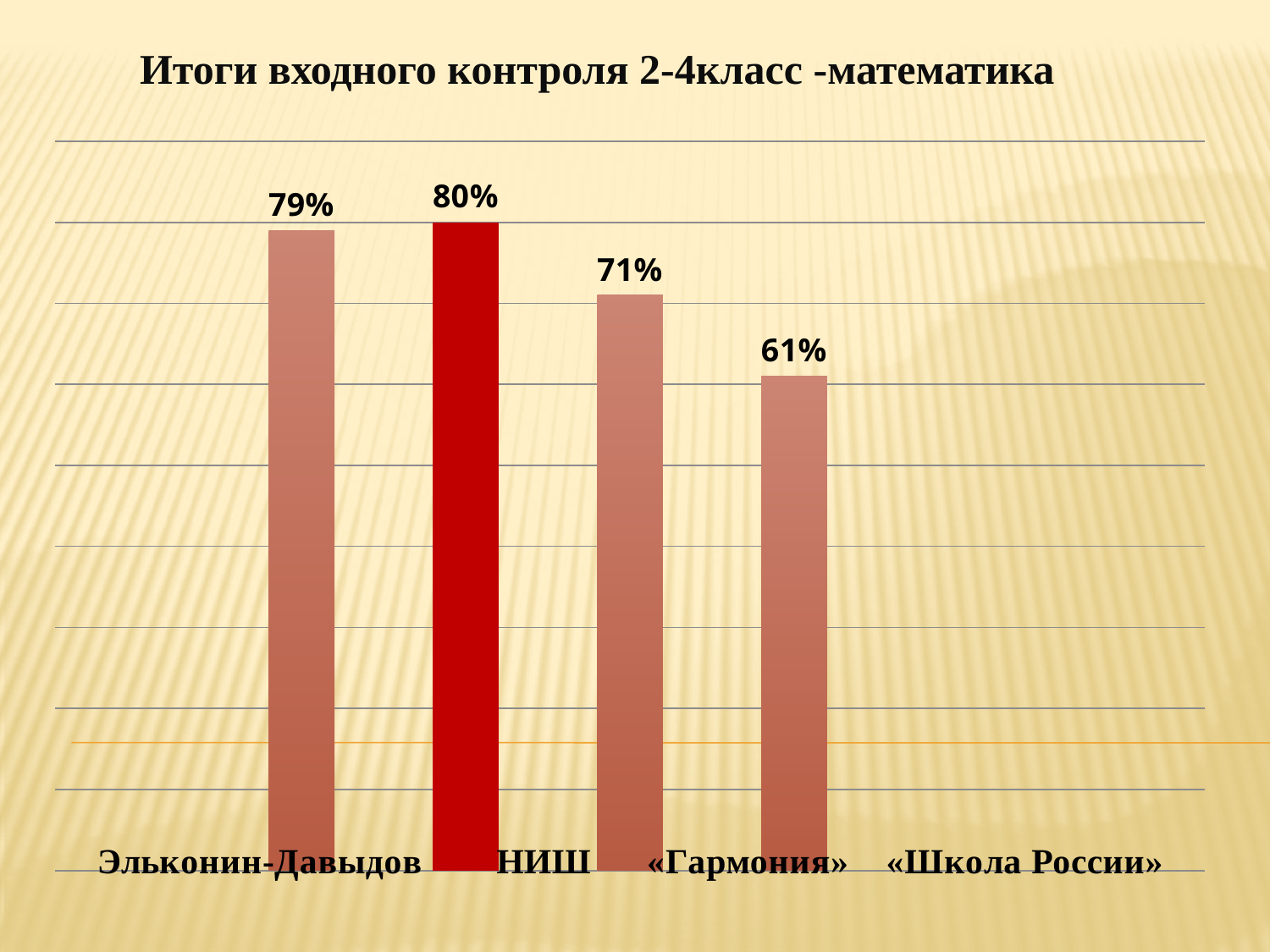
Which category has the highest value? НИШ What is the value for «Школа России»? 61% What kind of chart is shown on the slide? Bar chart How many categories are shown in the chart? 4 What is the value for «Гармония»? 71% What is the difference between the values for Эльконин-Давыдов and «Гармония»? 8% What is the value for Эльконин-Давыдов? 79% What is the value for НИШ? 80% Which is larger, the value for «Гармония» or the value for «Школа России»? «Гармония» What is the title of the chart? Итоги входного контроля 2-4класс -математика What is the difference between the values for НИШ and «Школа России»? 19% Which category has the lowest value? «Школа России»